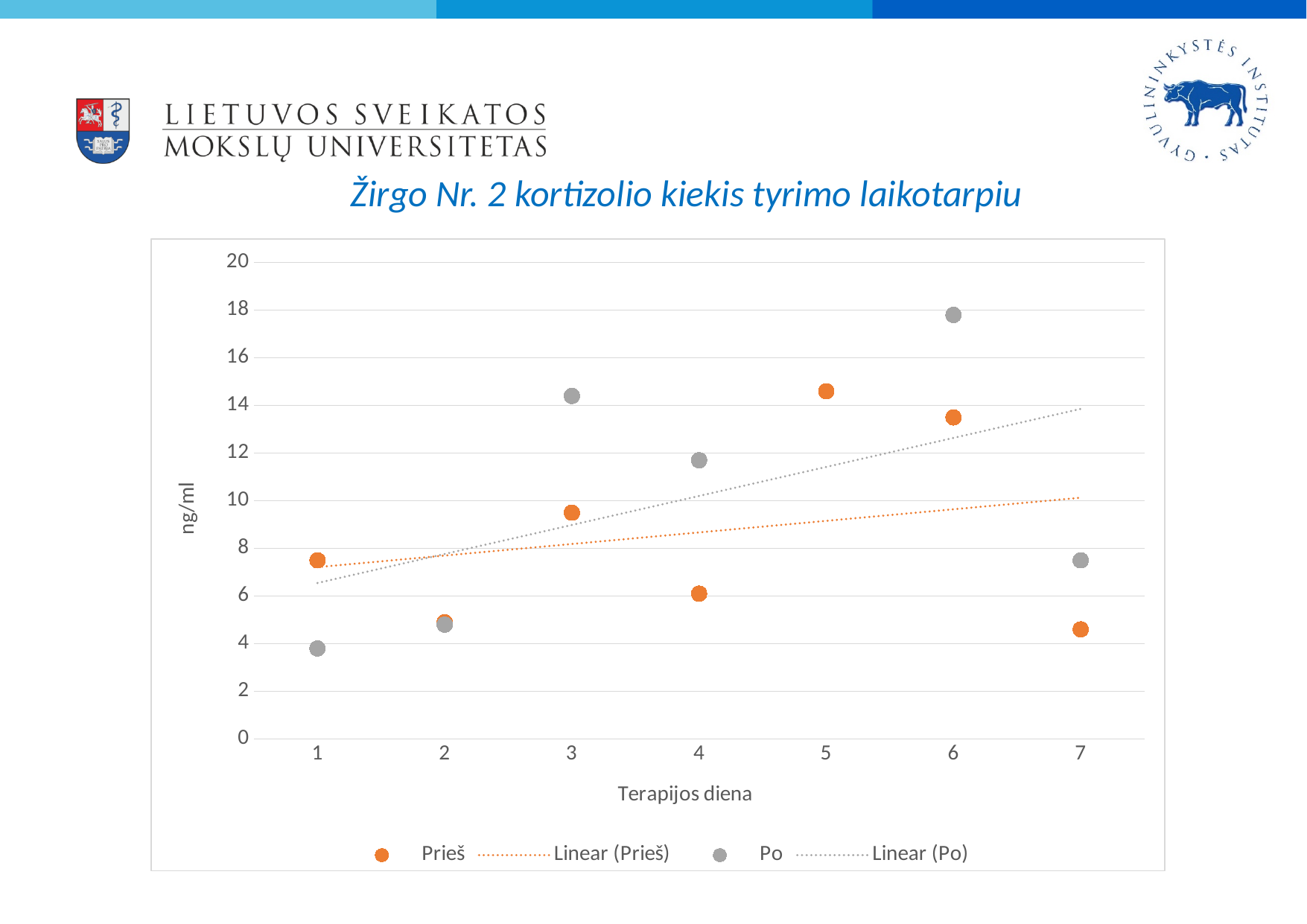
Is the Po value on day 6 greater or less than 16? greater Is the Prieš value on day 4 greater or less than 8? less On which therapy day is the Po value lowest? 1 What is the label of the y axis? ng/ml What kind of chart is shown on the slide? scatter chart On which therapy day is the Po value highest? 6 How many therapy days are marked on the x axis? 7 On day 1, which series has the larger value, Prieš or Po? Prieš Is the Po value on day 3 greater or less than 12? greater On which therapy day is the Prieš value highest? 5 How many entries does the chart legend list? 4 On day 3, which series has the larger value, Prieš or Po? Po